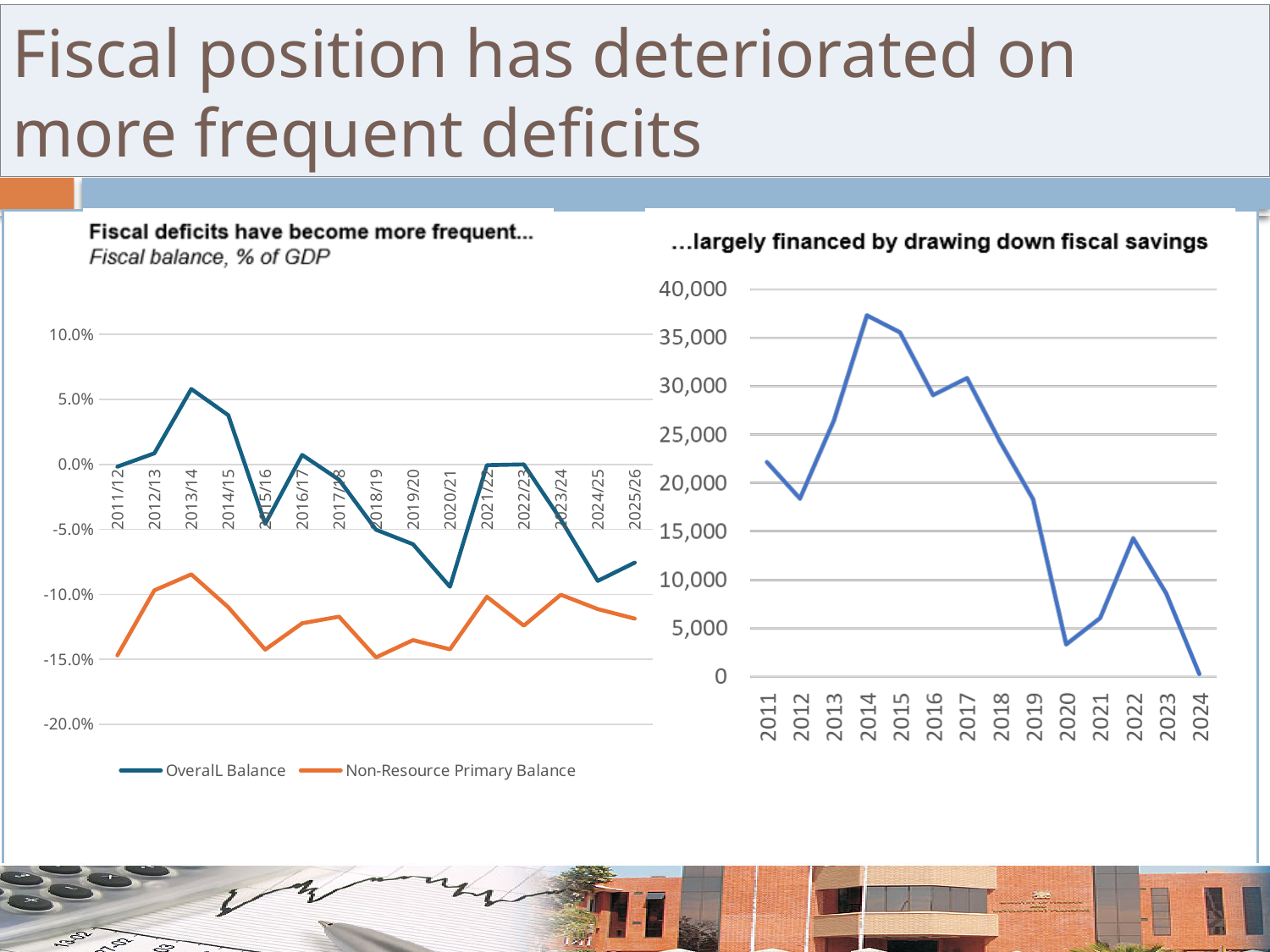
In the chart titled "...largely financed by drawing down fiscal savings", do the values generally rise or fall from 2014 to 2024? fall In the chart titled "Fiscal deficits have become more frequent...", which is larger: the Overall Balance for 2013/14 or for 2014/15? 2013/14 In the chart titled "Fiscal deficits have become more frequent...", in which fiscal year is the Overall Balance highest? 2013/14 What kind of chart is the chart titled "Fiscal deficits have become more frequent..."? line chart In the chart titled "...largely financed by drawing down fiscal savings", how many years are shown on the x axis? 14 How many series does the legend list in the chart titled "Fiscal deficits have become more frequent..."? 2 In the chart titled "...largely financed by drawing down fiscal savings", is the value for 2020 greater or less than 5,000? less In the chart titled "...largely financed by drawing down fiscal savings", which year has the lowest value? 2024 In the chart titled "Fiscal deficits have become more frequent...", is the Overall Balance for 2013/14 greater or less than 5.0%? greater In the chart titled "...largely financed by drawing down fiscal savings", which year has the highest value? 2014 In the chart titled "Fiscal deficits have become more frequent...", how many fiscal years are shown on the x axis? 15 In the chart titled "Fiscal deficits have become more frequent...", is the Non-Resource Primary Balance for 2011/12 greater or less than -10.0%? less